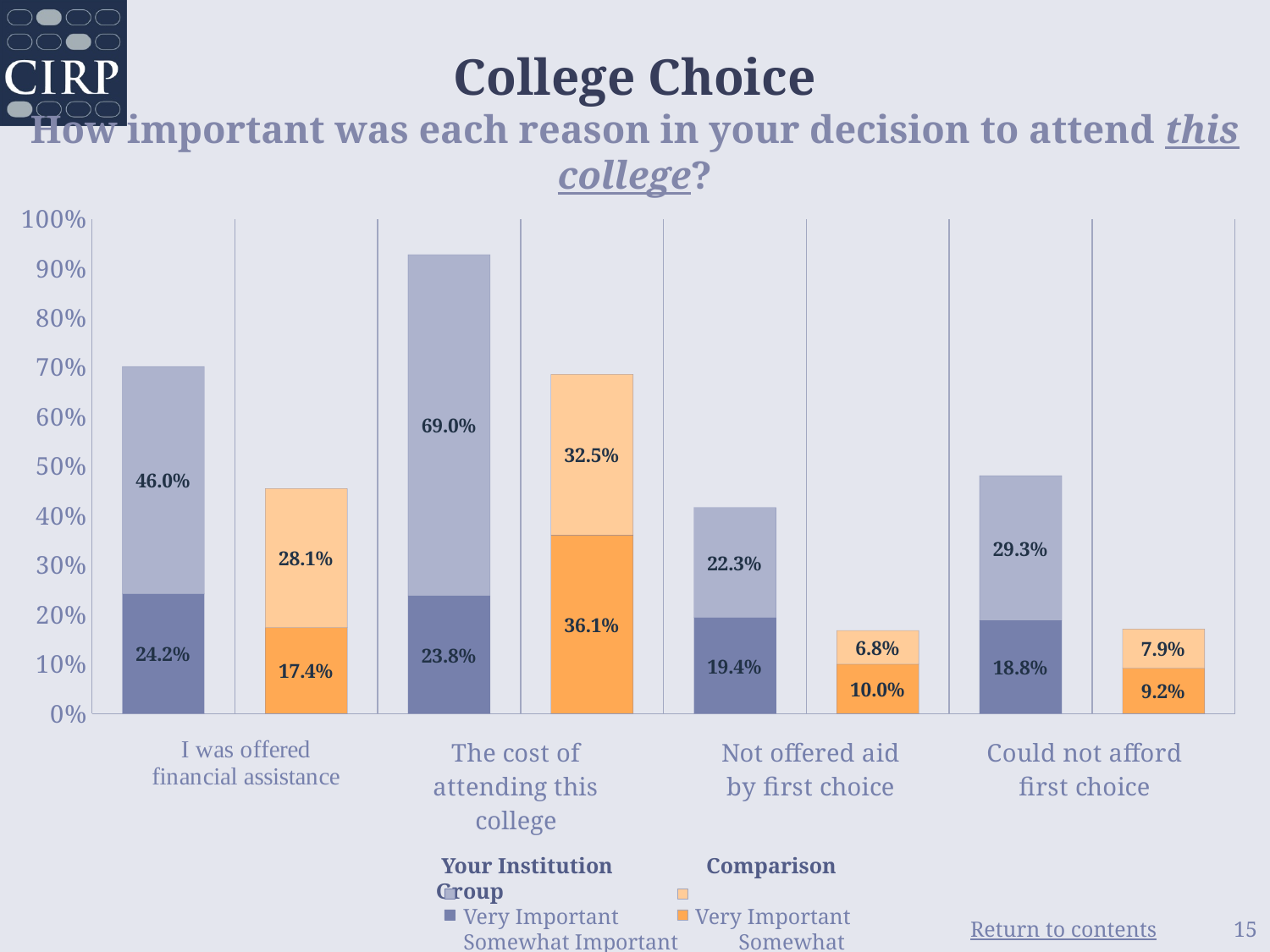
What is the total height of the Comparison Group bar for 'Could not afford first choice'? 17.1% Which reason has the tallest Your Institution bar? The cost of attending this college What percentage of Your Institution students rated 'The cost of attending this college' as Somewhat Important? 23.8% What kind of chart is shown on the slide? stacked bar chart What percentage of Your Institution students rated 'Not offered aid by first choice' as Very Important? 22.3% For 'Could not afford first choice', which group has the larger Very Important percentage, Your Institution or the Comparison Group? Your Institution What is the total height of the Your Institution bar for 'I was offered financial assistance'? 70.2% What percentage of the Comparison Group rated 'I was offered financial assistance' as Very Important? 28.1% How many series does the legend list? 4 How many reasons (categories) are shown on the x axis? 4 Which reason has the shortest Comparison Group bar? Not offered aid by first choice